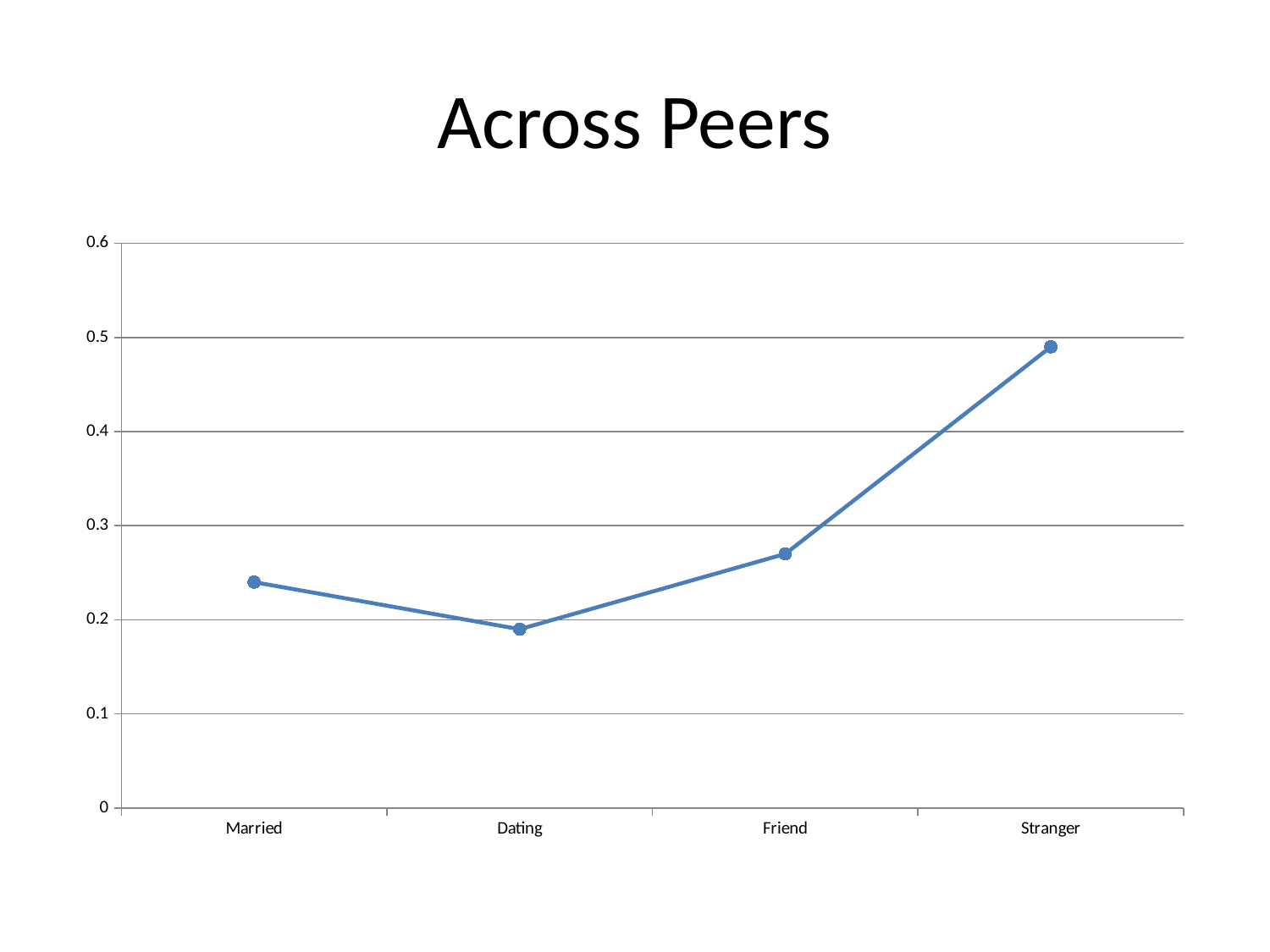
What kind of chart is shown on the slide? line chart Which has the larger value, Stranger or Friend? Stranger Which category has the highest value? Stranger What is the title of the slide? Across Peers Is the value for Friend greater or less than 0.3? less Which category has the lowest value? Dating Does the line rise or fall from Married to Dating? fall Is the value for Married greater or less than 0.2? greater How many categories are plotted along the x axis? 4 Is the value for Stranger greater or less than 0.4? greater Which has the larger value, Married or Dating? Married Does the line rise or fall from Friend to Stranger? rise